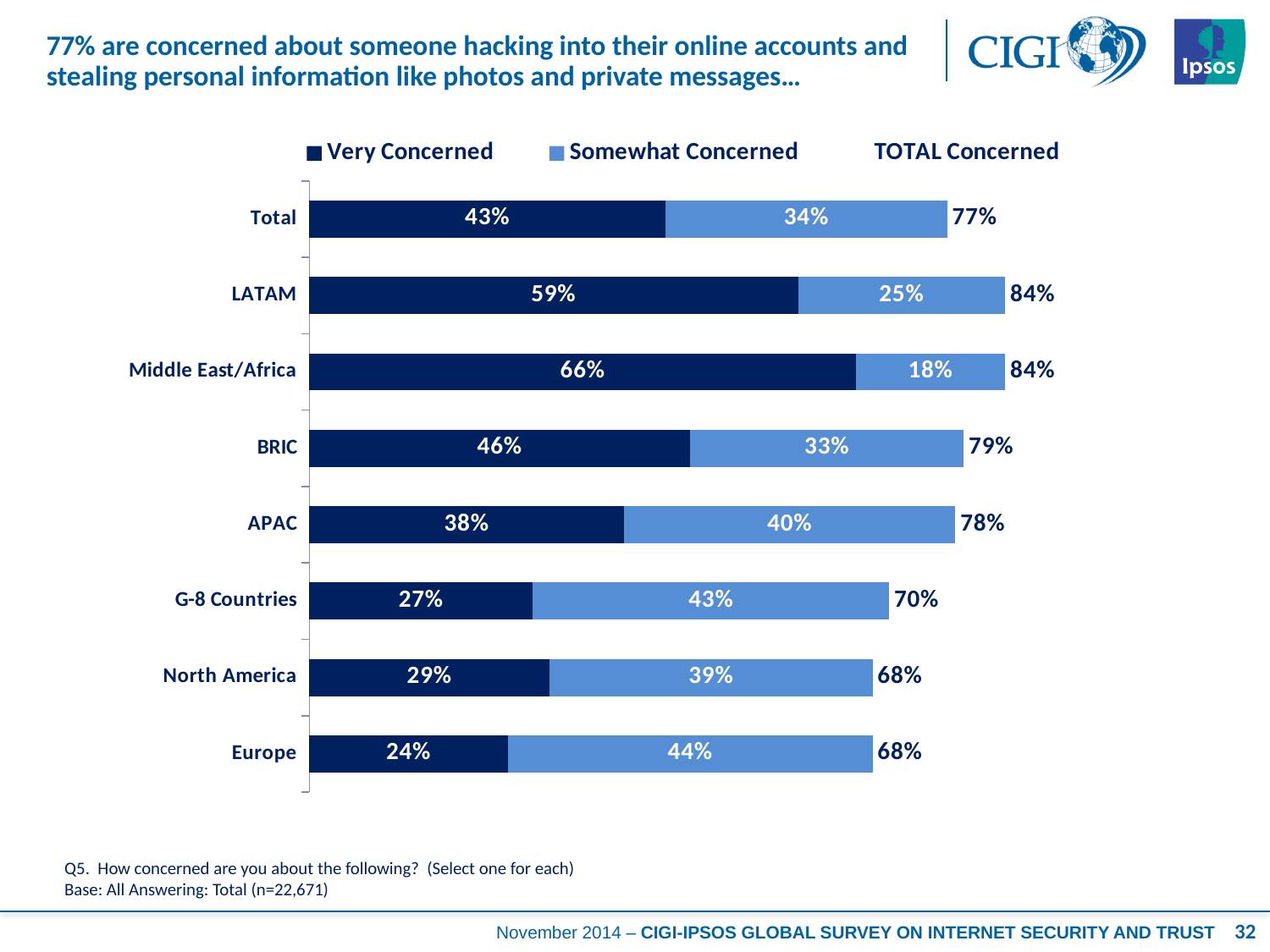
How many categories are shown on the chart? 8 What is the TOTAL Concerned value for G-8 Countries? 70% Which region has the highest Very Concerned percentage? Middle East/Africa How many series does the legend list with a colour swatch? 2 What is the Somewhat Concerned value for APAC? 40% Which region has the lowest Very Concerned percentage? Europe Which is larger: the Very Concerned value for BRIC or for APAC? BRIC What percentage of respondents in LATAM are Very Concerned? 59% What is the TOTAL Concerned value for North America? 68% Which category has the highest Somewhat Concerned percentage? Europe What is the difference between the Very Concerned values for Middle East/Africa and Europe? 42% What kind of chart is shown on the slide? Bar chart